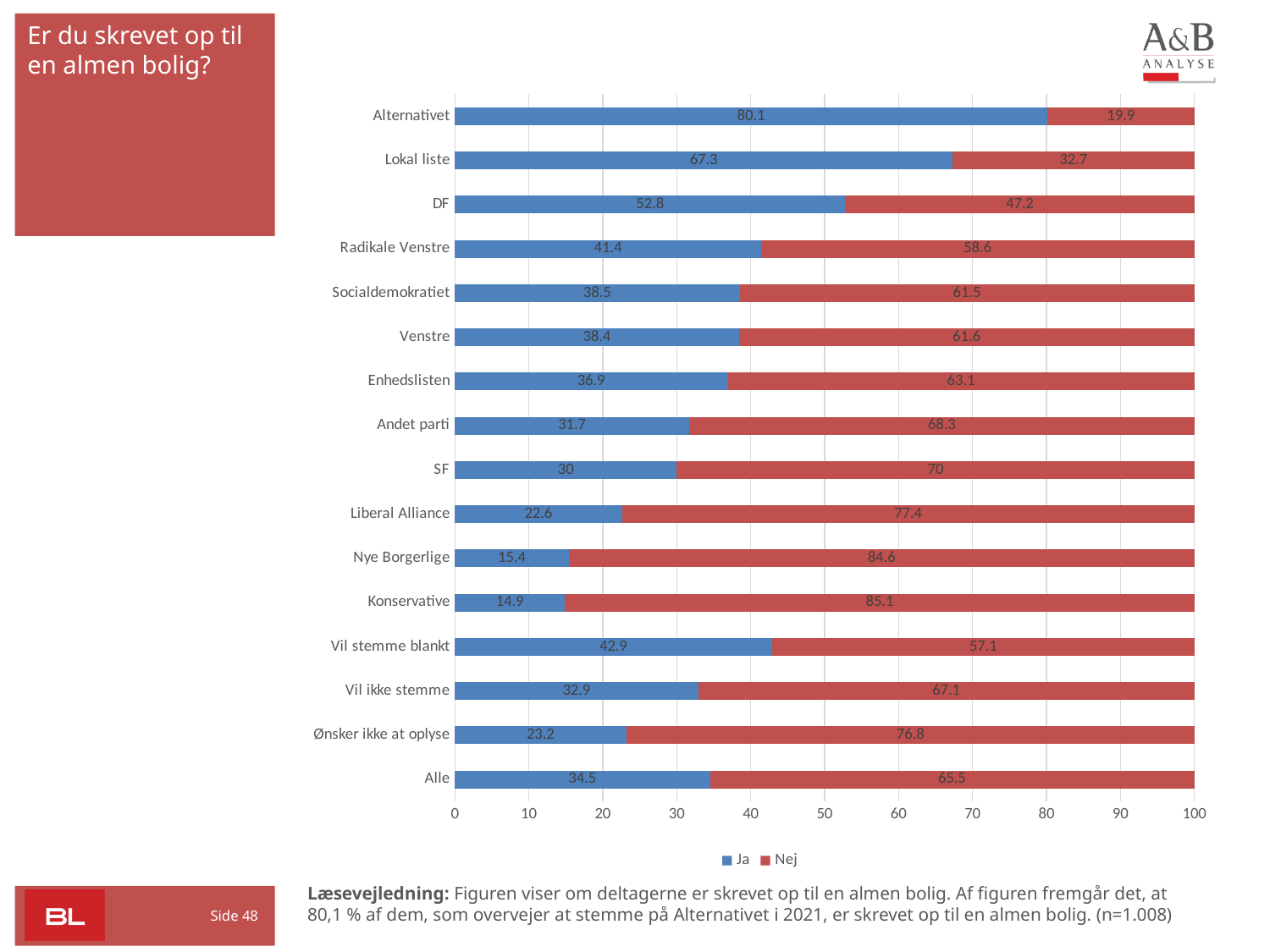
How many series does the legend list? 2 Which has a larger "Ja" value, DF or Radikale Venstre? DF What is the "Nej" value for Konservative? 85.1 What is the difference between the "Ja" values for Alternativet and Lokal liste? 12.8 What is the total of the stacked bar for SF? 100 Which category has the highest "Ja" value? Alternativet What is the "Ja" value for Alternativet? 80.1 How many categories are shown on the y axis? 16 Which category has the lowest "Ja" value? Konservative What are the two legend entries? Ja and Nej What kind of chart is shown? Stacked bar chart What is the "Ja" value for Alle? 34.5